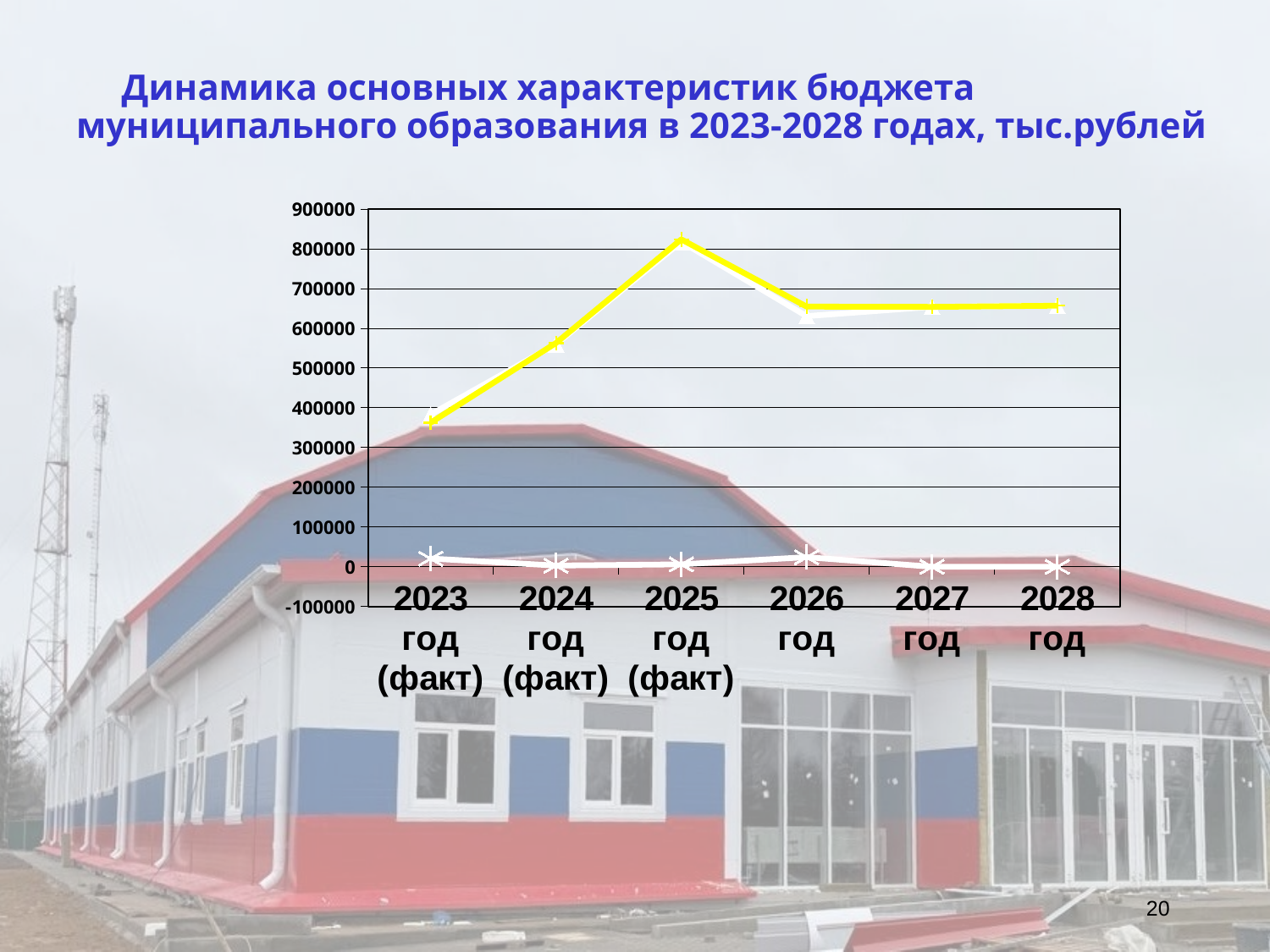
What kind of chart is shown on the slide? line chart Which is larger for the yellow line: the value for 2025 год (факт) or the value for 2026 год? 2025 год (факт) Is the value of the lower white line (with star markers) for 2026 год greater or less than 100000? less How many years (categories) are shown along the x axis of the chart? 6 Is the value of the yellow line for 2023 год (факт) greater or less than 400000? less Does the yellow line rise or fall from 2023 год (факт) to 2025 год (факт)? rise How many of the x-axis categories are marked as (факт)? 3 In which year does the yellow line reach its highest value? 2025 год (факт) Is the value of the yellow line for 2026 год greater or less than 700000? less In which year does the yellow line have its lowest value? 2023 год (факт)